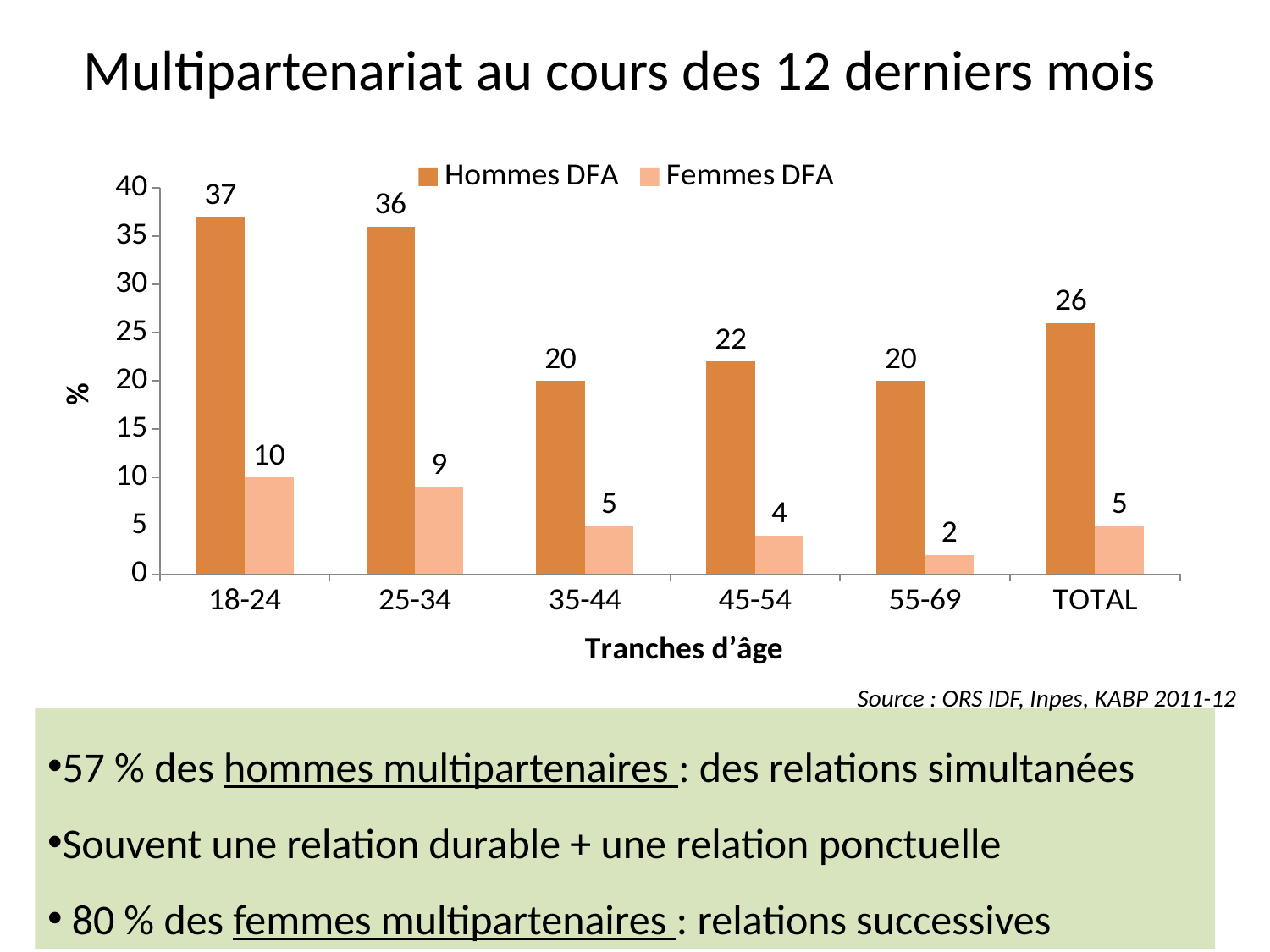
What is the label of the x axis? Tranches d’âge Which age group has the highest value for Hommes DFA? 18-24 How many series does the legend list? 2 Is the Hommes DFA value for 25-34 greater or less than 30? greater How many age-group categories are shown on the x axis? 6 Which is larger, the Hommes DFA value for 35-44 or for 45-54? 45-54 Which age group has the lowest value for Femmes DFA? 55-69 What is the difference between Hommes DFA and Femmes DFA in the 45-54 age group? 18 What kind of chart is shown on the slide? bar chart What is the value for Femmes DFA in the 25-34 age group? 9 What is the value for Hommes DFA in the 18-24 age group? 37 What is the TOTAL value for Hommes DFA? 26